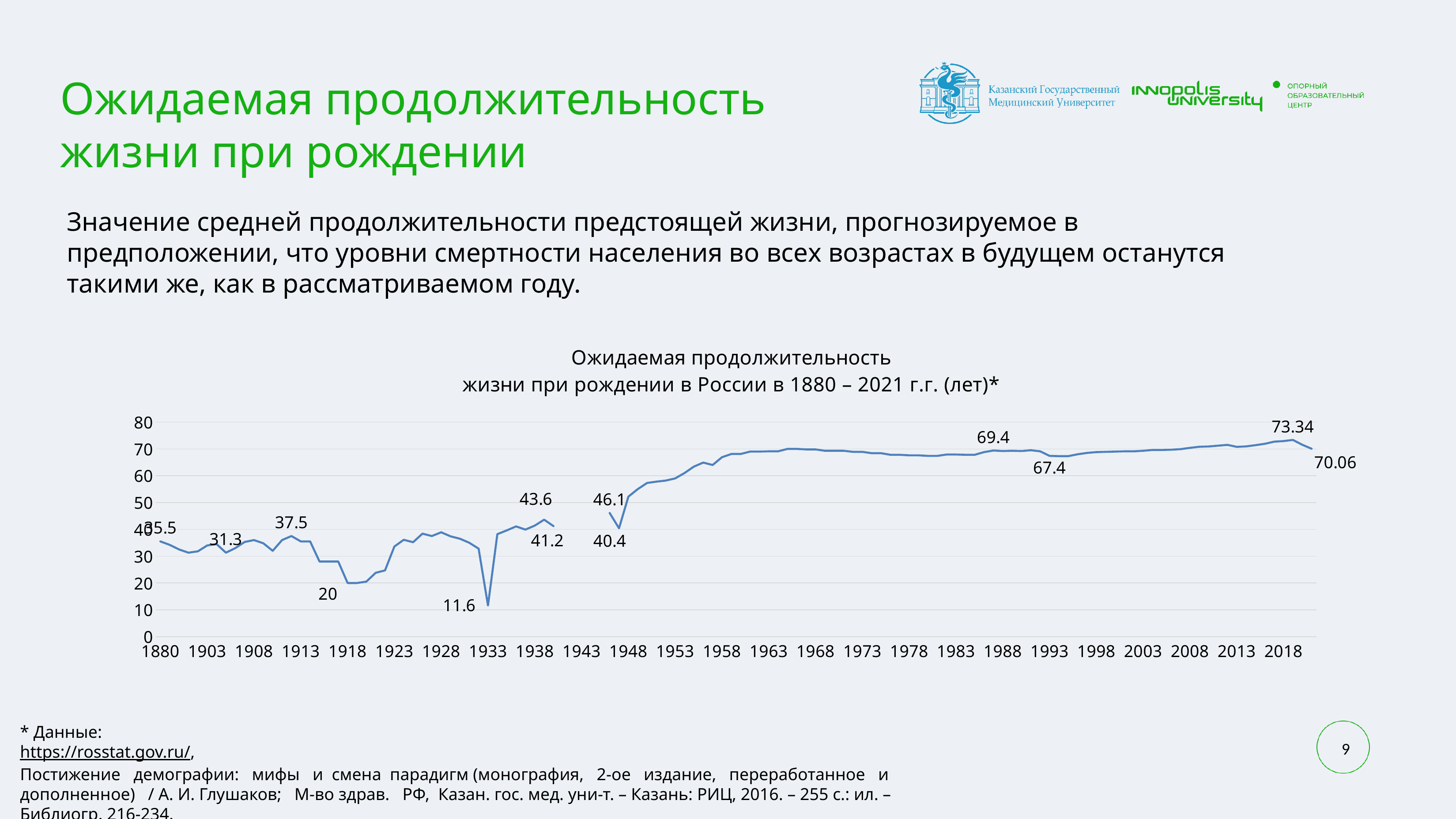
Is the value for 1968 greater or less than 60? greater Which labelled value is larger: 43.6 or 46.1? 46.1 What is the life expectancy value labelled at the deep dip around 1933? 11.6 What is the title of the chart? Ожидаемая продолжительность жизни при рождении в России в 1880 – 2021 г.г. (лет)* What is the life expectancy value labelled at the first point of the line, in 1880? 35.5 What is the difference between the labelled values 69.4 and 67.4 near 1988 and 1993? 2 Overall, does life expectancy rise or fall from 1880 to 2021 along the x axis? rise What is the highest value labelled on the chart? 73.34 What is the difference between the labelled peak value 73.34 and the final labelled value 70.06? 3.28 What kind of chart is shown on the slide? line chart What is the lowest value labelled on the chart? 11.6 What is the value labelled at the last point of the line, at the right end of the chart? 70.06